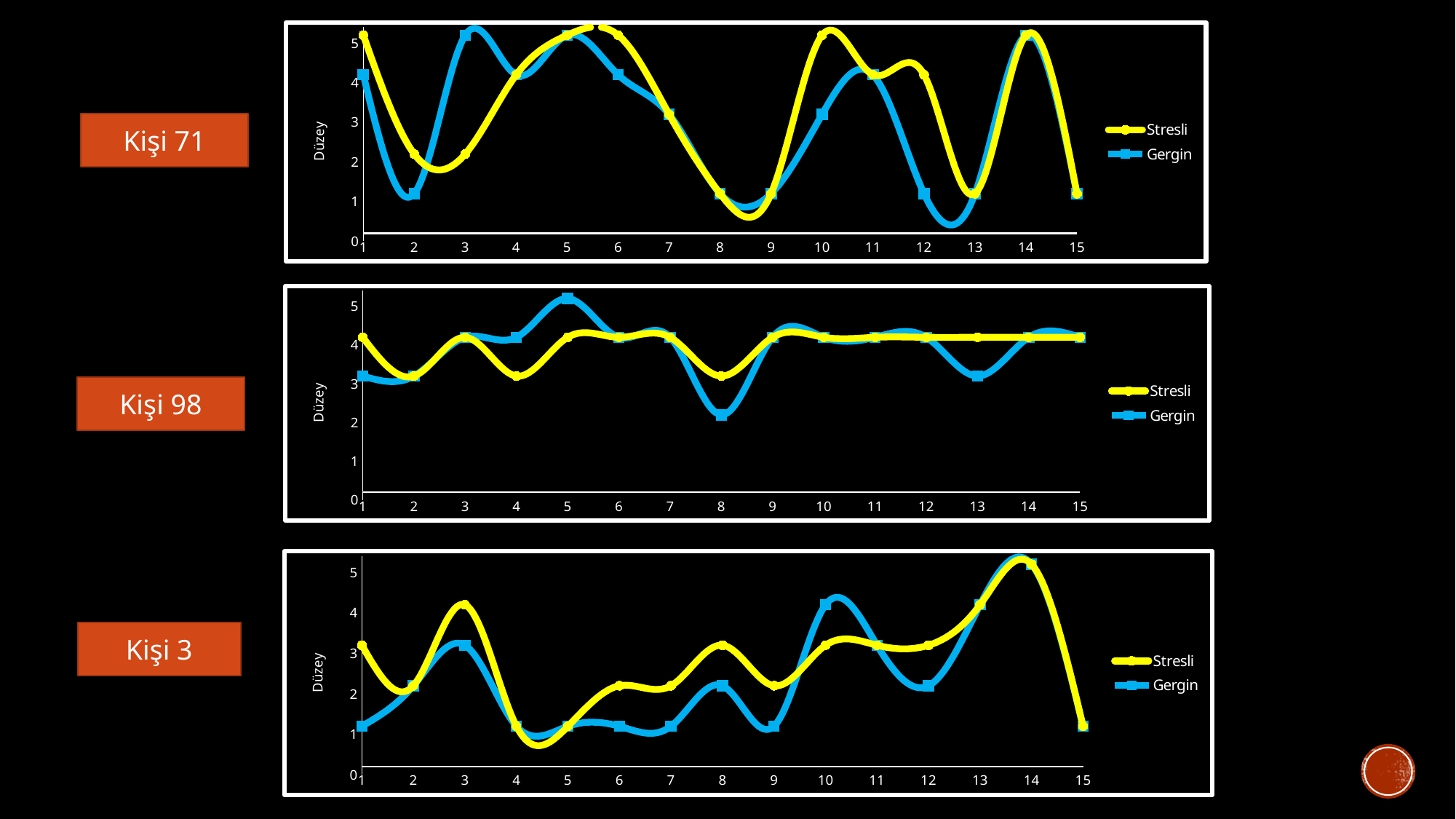
How many series does the legend list in the Kişi 98 chart? 2 What is the y-axis label on the Kişi 3 chart? Düzey In the Kişi 71 chart, what is the Stresli value at point 8? 1 What kind of chart is used for Kişi 71? Line chart In the Kişi 3 chart, at point 3, which series has the higher value, Stresli or Gergin? Stresli In the Kişi 71 chart, is the Gergin value at point 12 greater or less than 3? less In the Kişi 98 chart, what is the Gergin value at point 8? 2 In the Kişi 71 chart, what is the Gergin value at point 3? 5 In the Kişi 3 chart, what is the Stresli value at point 14? 5 In the Kişi 98 chart, at which point does Gergin reach its lowest value? 8 In the Kişi 98 chart, what is the Gergin value at point 5? 5 How many points are plotted along the x axis in the Kişi 3 chart? 15